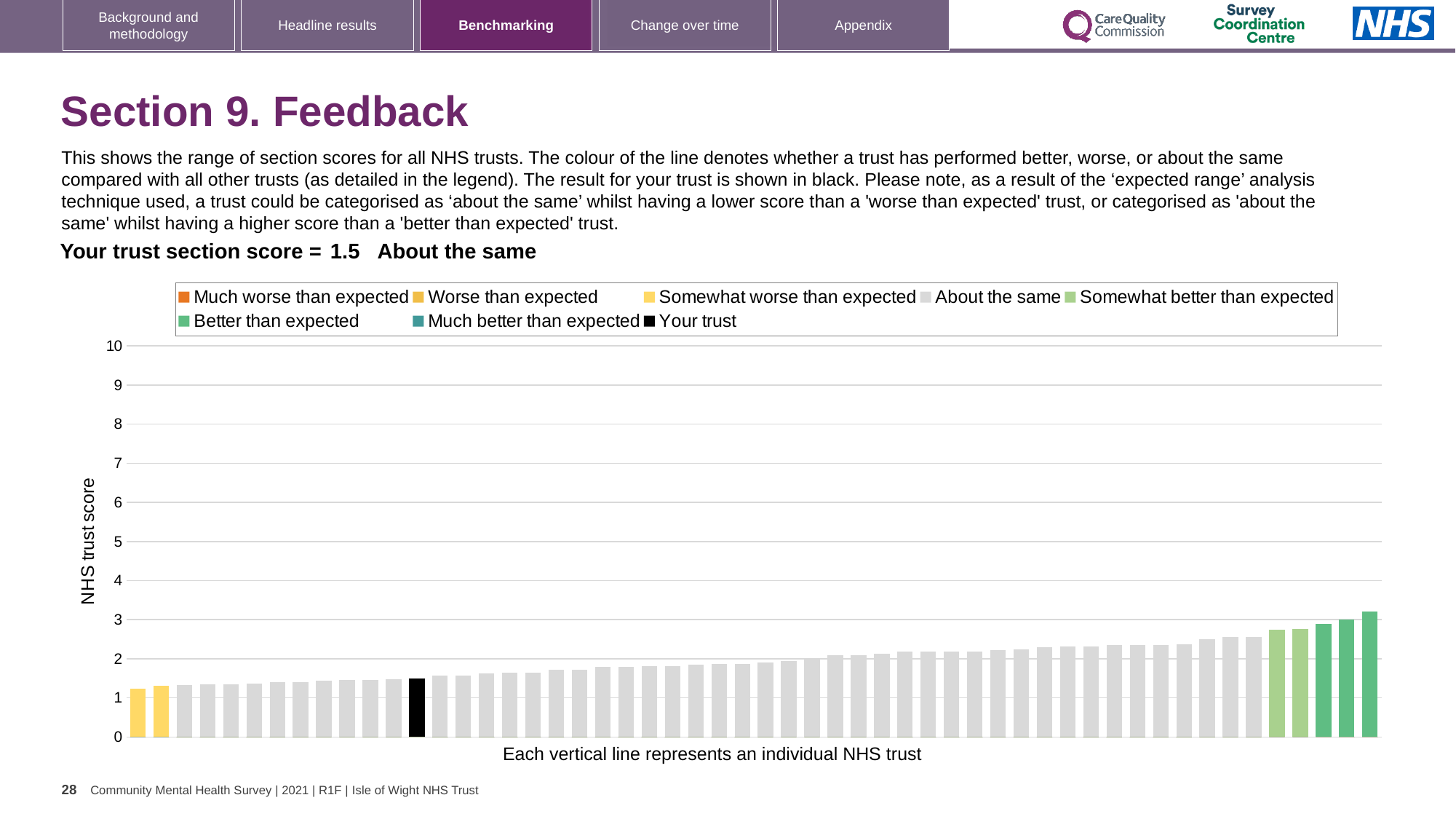
Which is larger: the leftmost bar or the rightmost bar? the rightmost bar How many bars are coloured as 'Somewhat worse than expected' (yellow)? 2 Do the bar values rise or fall from left to right along the x axis? rise What colour is the bar representing your trust? black What is the label on the y axis of the chart? NHS trust score How many entries does the chart legend list? 8 Is the value of the highest bar greater or less than 4? less Is the value for your trust (the black bar) greater or less than 2? less Which category is your trust's section score placed in? About the same What is the section score for your trust shown on the slide? 1.5 Is the value of the lowest bar greater or less than 2? less What kind of chart is shown on the slide? bar chart